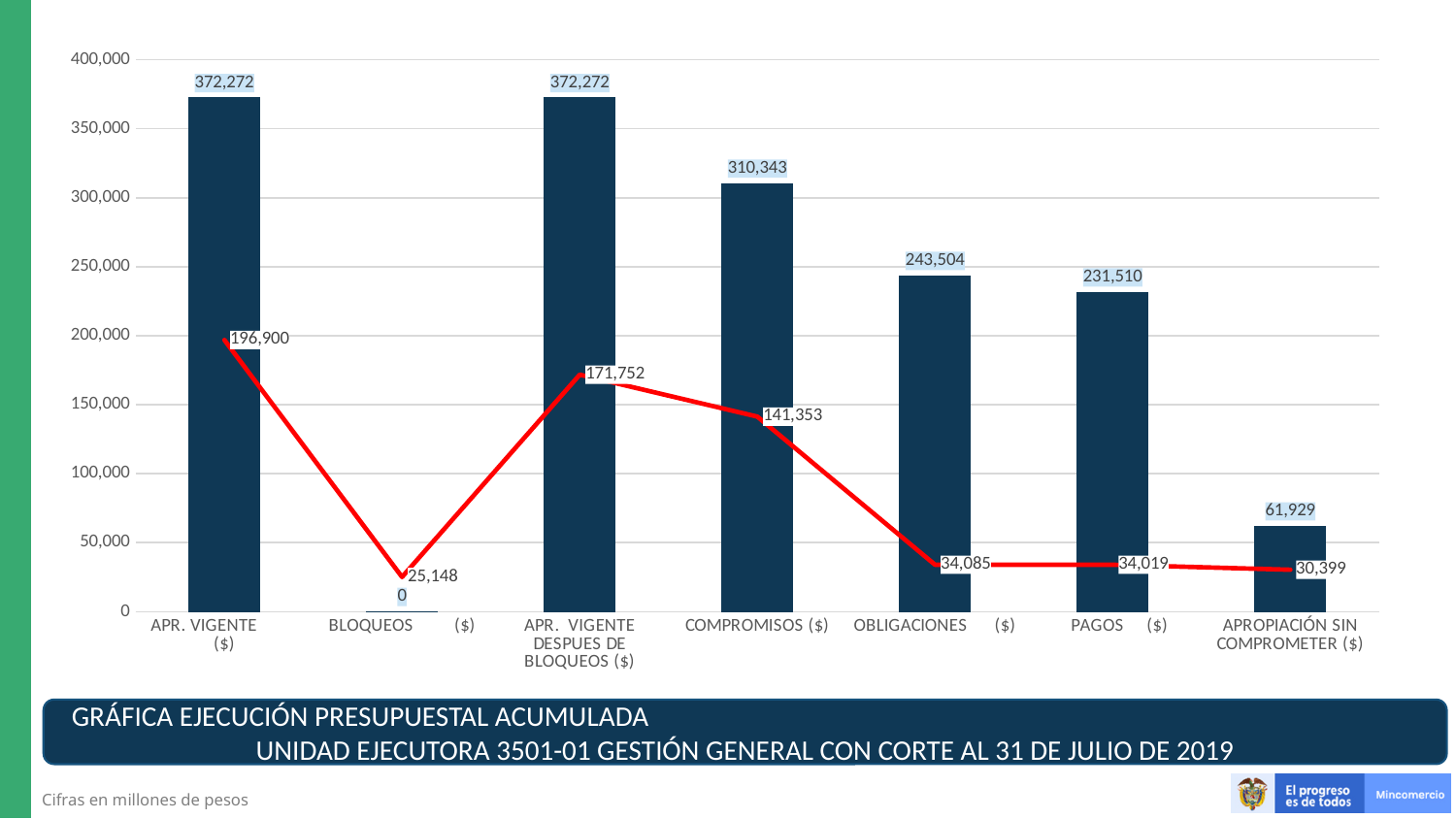
What is the bar value for COMPROMISOS ($)? 310,343 How many categories are shown on the x axis? 7 Does the red line rise or fall from COMPROMISOS ($) to APROPIACIÓN SIN COMPROMETER ($)? Fall What is the difference between the bar values for COMPROMISOS ($) and OBLIGACIONES ($)? 66,839 What is the bar value for PAGOS ($)? 231,510 Which category has the lowest bar value? BLOQUEOS ($) What kind of chart is shown on the slide? A bar chart combined with a line Which has the larger bar value, OBLIGACIONES ($) or PAGOS ($)? OBLIGACIONES ($) At which category does the red line reach its highest value? APR. VIGENTE ($) What value does the red line show for BLOQUEOS ($)? 25,148 For APROPIACIÓN SIN COMPROMETER ($), what is the difference between the bar value and the red line value? 31,530 What value does the red line show for OBLIGACIONES ($)? 34,085